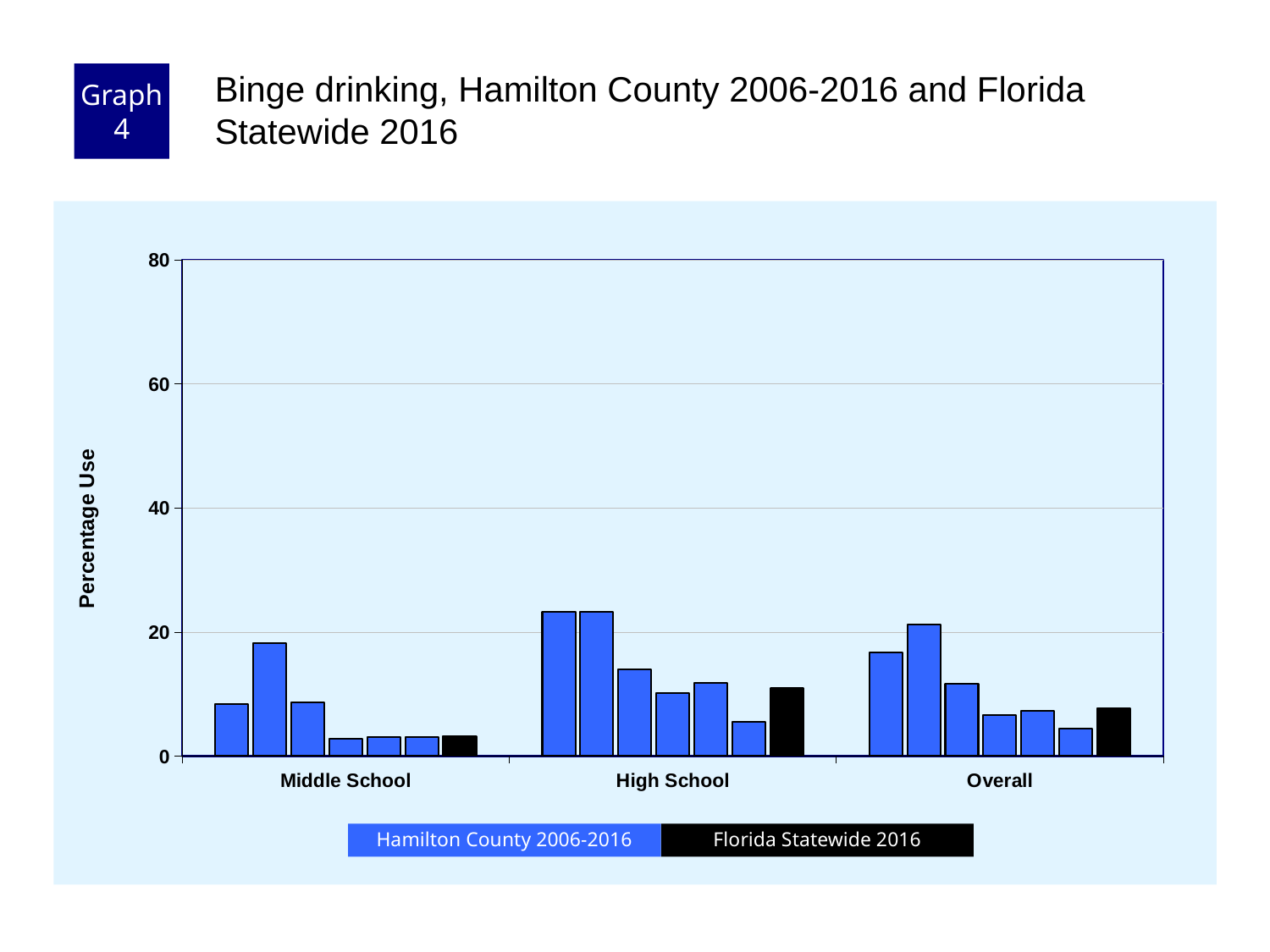
How many categories are shown along the x axis? 3 What is the title of the y axis? Percentage Use Which category has the highest Florida Statewide 2016 value? High School What kind of chart is shown on the slide? bar chart Is the tallest Hamilton County 2006-2016 bar for High School greater or less than 20? greater Which category contains the tallest bar in the chart? High School Which is larger, the Florida Statewide 2016 value for High School or for Middle School? High School Is the Florida Statewide 2016 value for High School greater or less than 20? less What colour are the Florida Statewide 2016 bars? black How many series does the legend list? 2 Which category has the lowest Florida Statewide 2016 value? Middle School Is the tallest Hamilton County 2006-2016 bar for Overall greater or less than 40? less